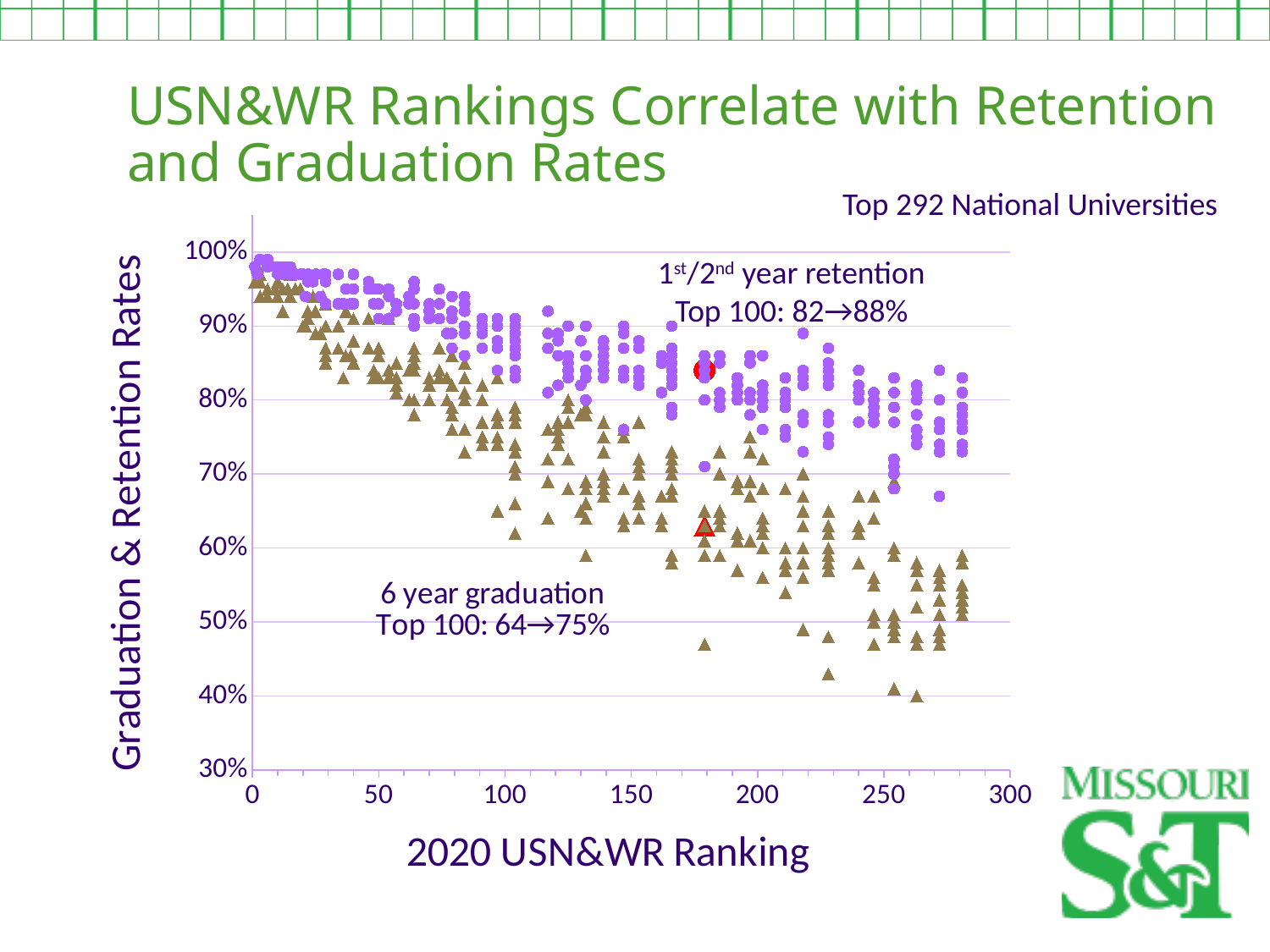
How many data series are plotted on the chart? 4 As the USN&WR ranking number increases along the x axis, do the retention and graduation rates rise or fall? Fall Which series has the higher values overall: 1st/2nd year retention or 6 year graduation? 1st/2nd year retention Is the value of the highlighted red triangle (6 year graduation) greater or less than 70%? less What is the title of the slide's chart? USN&WR Rankings Correlate with Retention and Graduation Rates According to the annotation, what is the Top 100 range for 1st/2nd year retention? 82→88% What kind of chart is shown on the slide? Scatter chart What is the label of the x axis? 2020 USN&WR Ranking What is the lowest value shown on the y axis? 30% How many national universities does the chart cover, according to the subtitle? 292 Is the value of the highlighted red circle (1st/2nd year retention) greater or less than 80%? greater According to the annotation, what is the Top 100 range for 6 year graduation? 64→75%